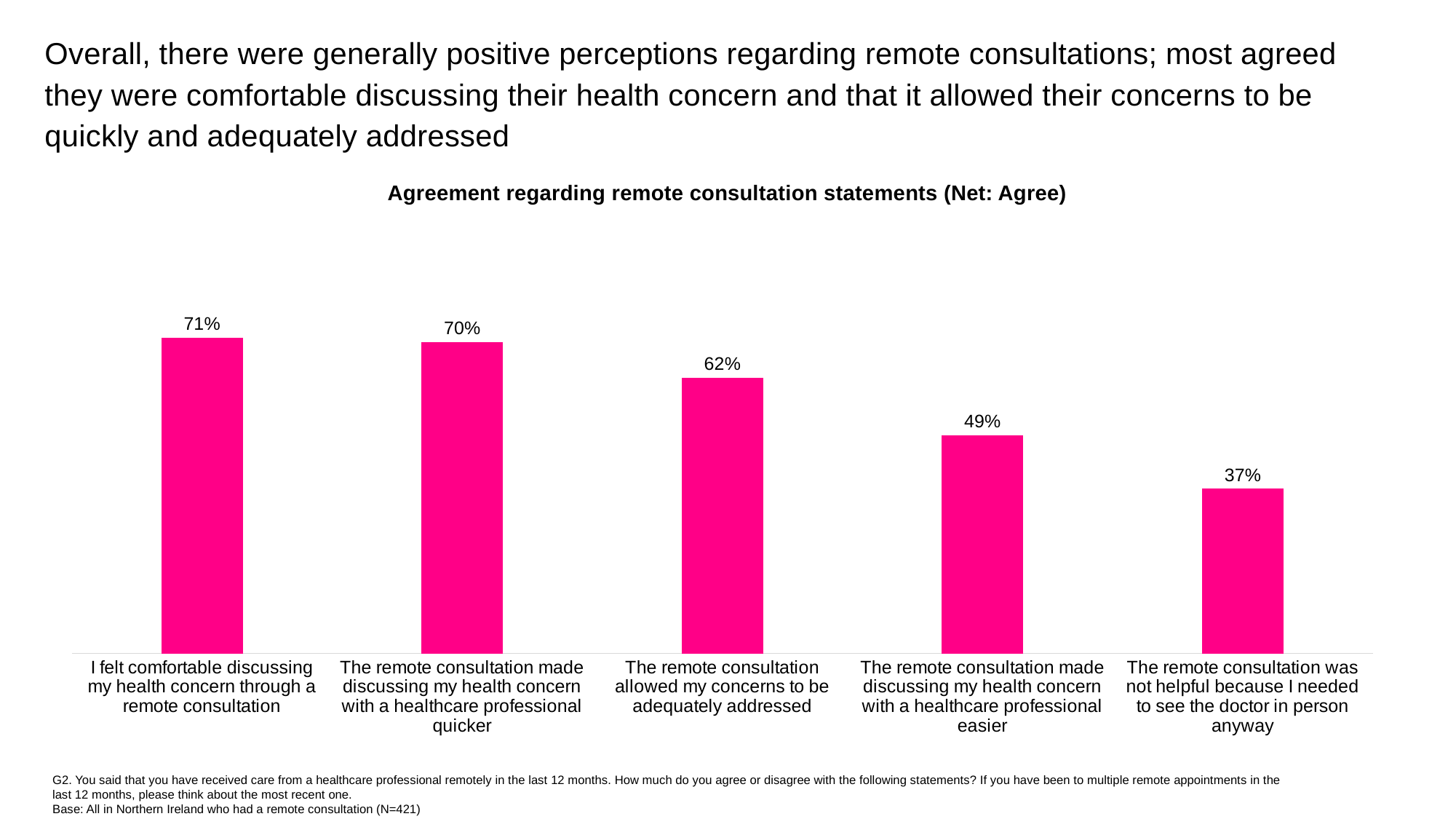
What is the difference between the agreement for 'The remote consultation made discussing my health concern with a healthcare professional quicker' and 'The remote consultation made discussing my health concern with a healthcare professional easier'? 21% Which statement has the highest level of agreement? I felt comfortable discussing my health concern through a remote consultation What is the value for 'The remote consultation made discussing my health concern with a healthcare professional easier'? 49% What is the value for 'The remote consultation allowed my concerns to be adequately addressed'? 62% Do the values rise or fall from left to right across the chart? Fall What is the title of the chart? Agreement regarding remote consultation statements (Net: Agree) Which has a higher agreement: 'The remote consultation allowed my concerns to be adequately addressed' or 'The remote consultation was not helpful because I needed to see the doctor in person anyway'? The remote consultation allowed my concerns to be adequately addressed Which statement has the lowest level of agreement? The remote consultation was not helpful because I needed to see the doctor in person anyway What percentage agreed with the statement 'I felt comfortable discussing my health concern through a remote consultation'? 71% What type of chart is shown on the slide? Bar chart How many statements are shown in the chart? 5 What percentage agreed that the remote consultation was not helpful because they needed to see the doctor in person anyway? 37%